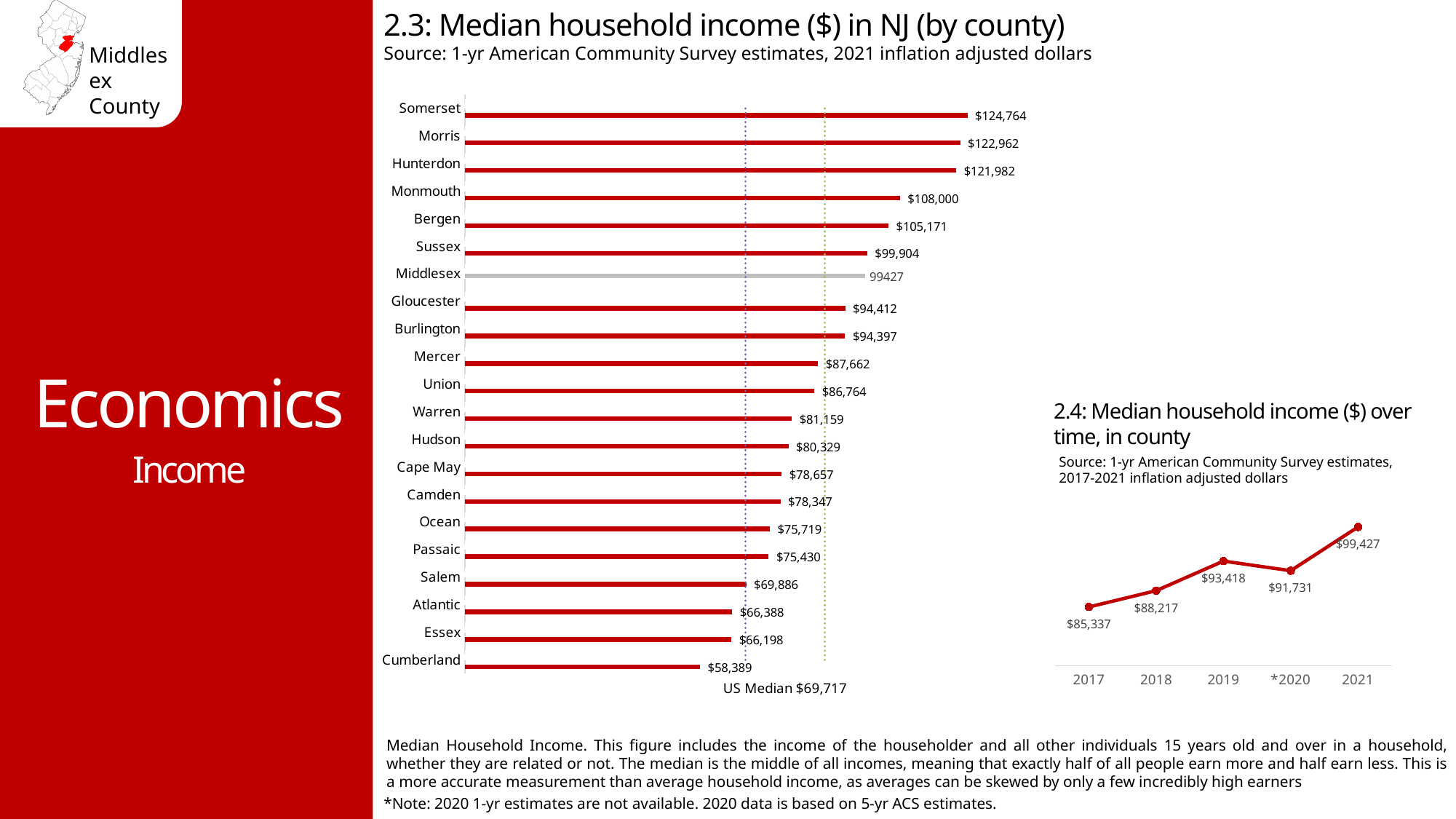
In chart 2.4 (Median household income over time, in county), what is the difference between the 2021 and 2017 values? $14,090 In chart 2.3 (Median household income in NJ by county), which county has the highest median household income? Somerset In chart 2.3 (Median household income in NJ by county), which county has the lowest median household income? Cumberland In chart 2.3 (Median household income in NJ by county), what is the median household income for Somerset? $124,764 In chart 2.3 (Median household income in NJ by county), which has a higher median household income, Bergen or Sussex? Bergen In chart 2.4 (Median household income over time, in county), what is the value for 2019? $93,418 In chart 2.3, what US Median value is noted below the chart? $69,717 In chart 2.3 (Median household income in NJ by county), what is the difference between Somerset and Cumberland? $66,375 In chart 2.3 (Median household income in NJ by county), how many counties are plotted? 21 In chart 2.3 (Median household income in NJ by county), what is the value shown for Middlesex? 99427 What kind of chart is chart 2.3 (Median household income in NJ by county)? Bar chart In chart 2.4 (Median household income over time, in county), which year has the lowest value? 2017